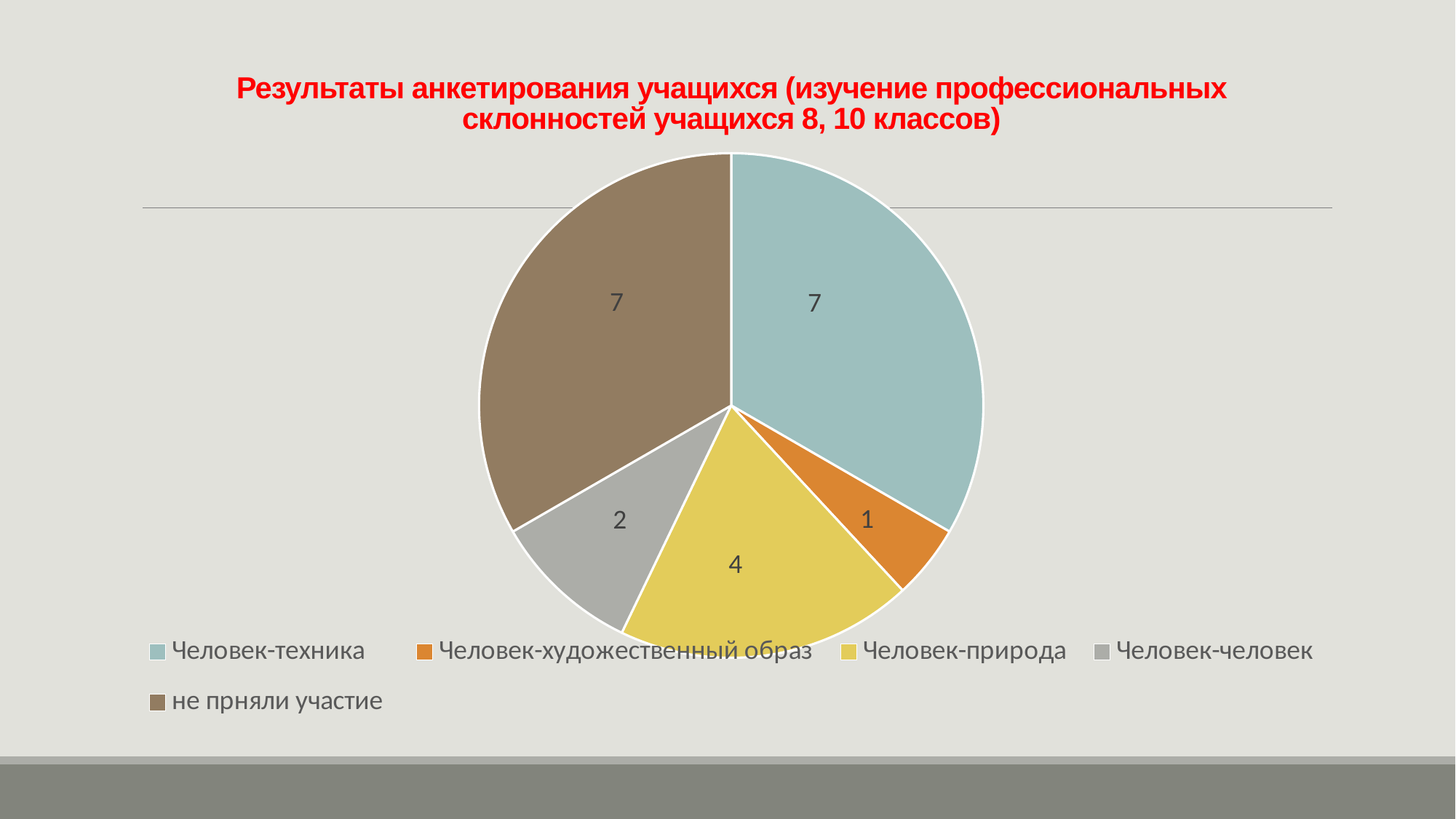
What is the difference between the values for Человек-природа and Человек-человек? 2 What is the value for Человек-художественный образ? 1 What colour is the slice for Человек-природа? yellow What is the value for Человек-техника? 7 Which category has the smallest slice? Человек-художественный образ What is the value for Человек-природа? 4 What is the value for не прняли участие? 7 Which is larger, the value for Человек-природа or the value for Человек-художественный образ? Человек-природа What is the value for Человек-человек? 2 What kind of chart is shown on the slide? pie chart How many slices does the pie chart have? 5 What is the total of all the slice values in the pie chart? 21